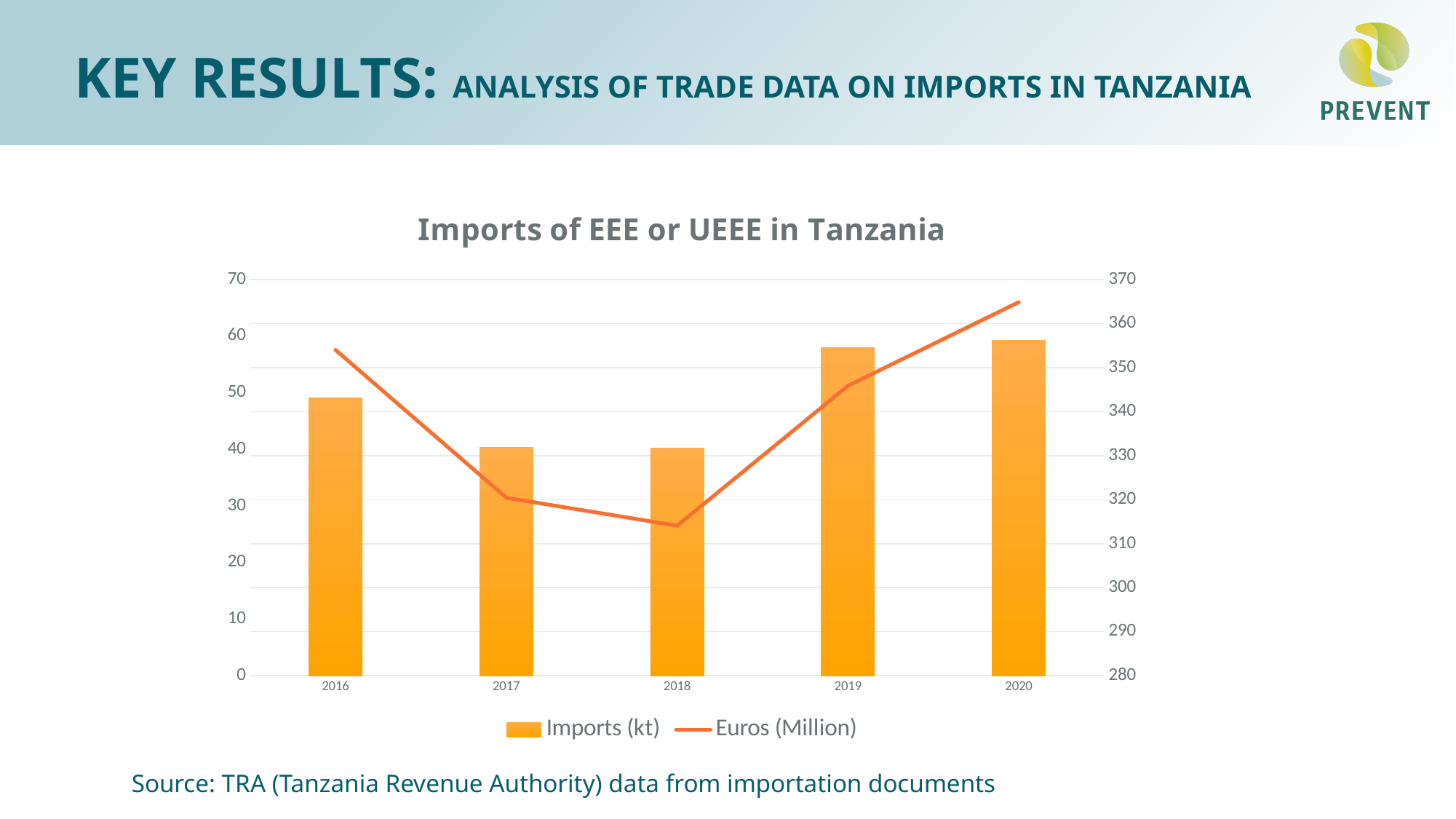
Is the Imports (kt) value for 2016 greater or less than 40? greater Which series is shown as a line in the chart? Euros (Million) How many years are shown on the x axis of the chart? 5 In which year is the Euros (Million) value lowest? 2018 What is the title of the chart? Imports of EEE or UEEE in Tanzania Do the Euros (Million) values rise or fall from 2018 to 2020? rise How many series does the chart legend list? 2 Which year has the larger Imports (kt) value, 2017 or 2019? 2019 Is the Imports (kt) value for 2017 greater or less than 50? less Is the Euros (Million) value for 2018 greater or less than 330? less What kind of chart is shown on the slide? A combined bar and line chart In which year is the Euros (Million) value highest? 2020